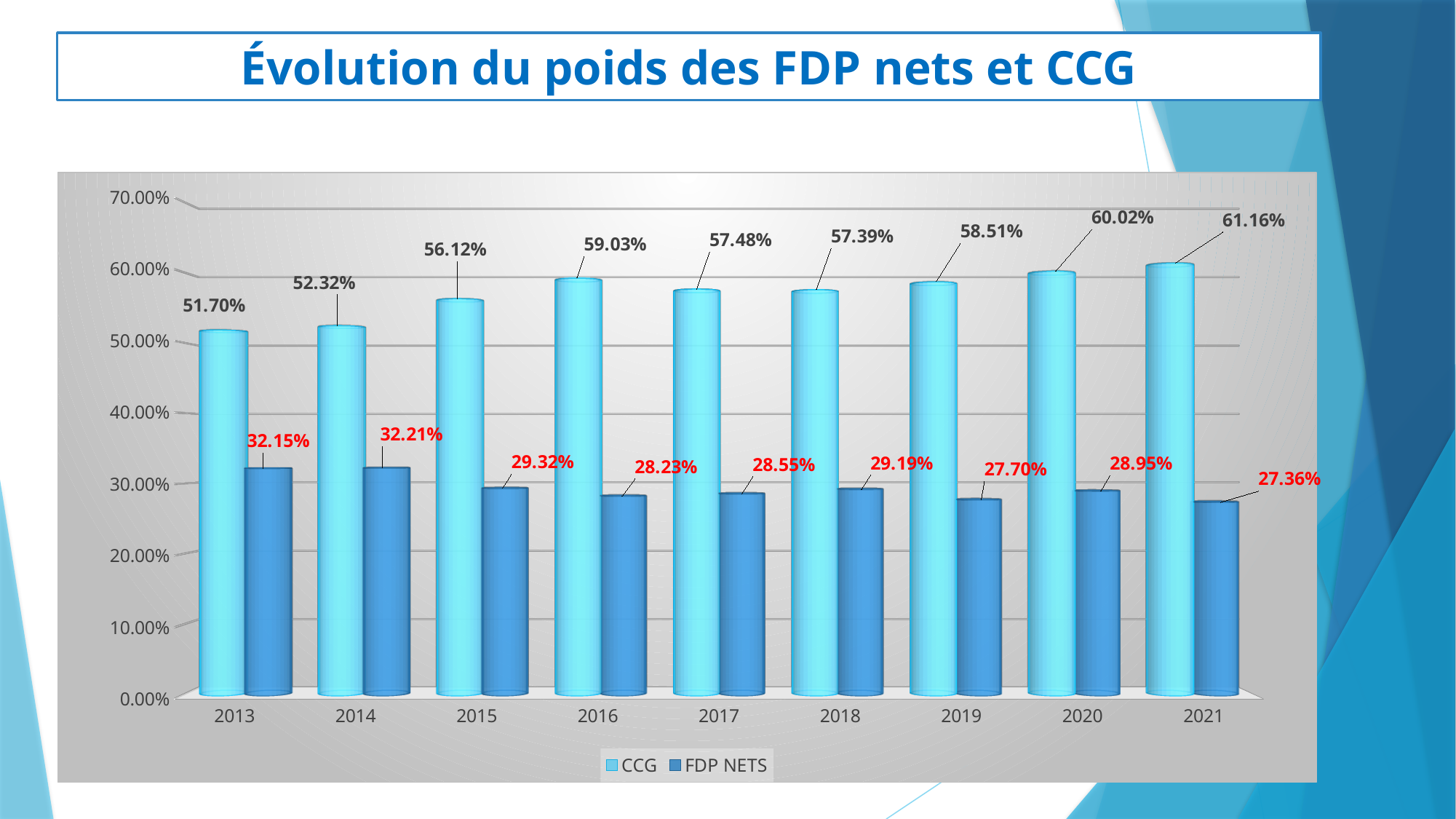
How many years are shown on the x axis? 9 What is the CCG value for 2018? 57.39% How many series does the legend list? 2 Is the FDP NETS value for 2019 greater or less than 30.00%? less Which is larger, the CCG value in 2016 or in 2017? 2016 What is the CCG value for 2013? 51.70% In which year is the CCG value lowest? 2013 What is the difference between the CCG value in 2021 and in 2013? 9.46 percentage points In which year is the CCG value highest? 2021 What is the FDP NETS value for 2021? 27.36% In which year is the FDP NETS value lowest? 2021 What kind of chart is shown on the slide? Bar chart